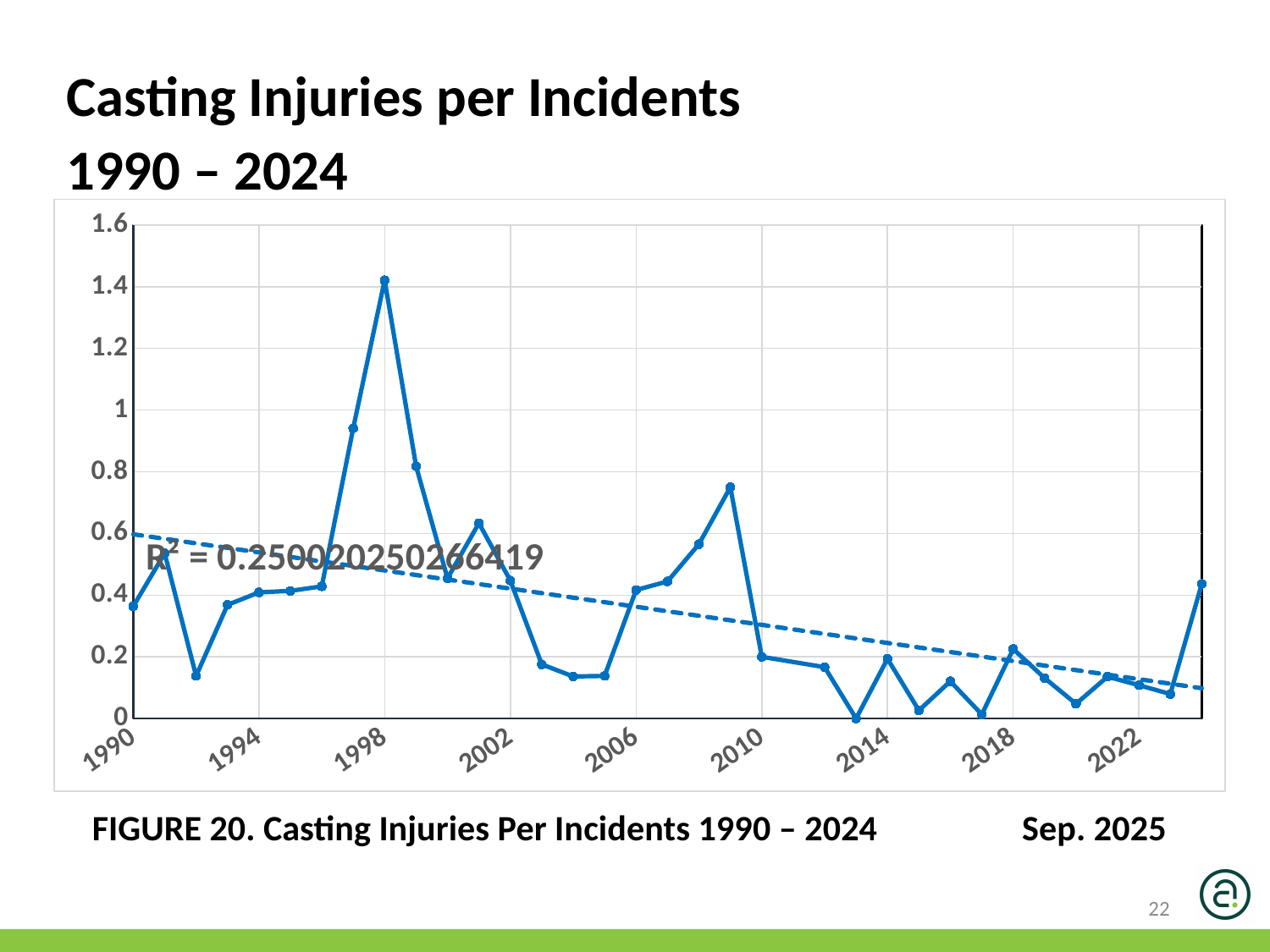
Which year has the larger value, 1998 or 2009? 1998 Is the value for 2010 greater or less than 0.4? less Is the value for 2024 greater or less than 0.2? greater Is the value for 1998 greater or less than 1.2? greater Does the dashed trend line rise or fall from 1990 to 2024? fall What kind of chart is shown on the slide? line chart Which year has the highest casting injuries per incidents value? 1998 What R-squared value is printed on the chart? R² = 0.250020250266419 Which year has the larger value, 2009 or 2010? 2009